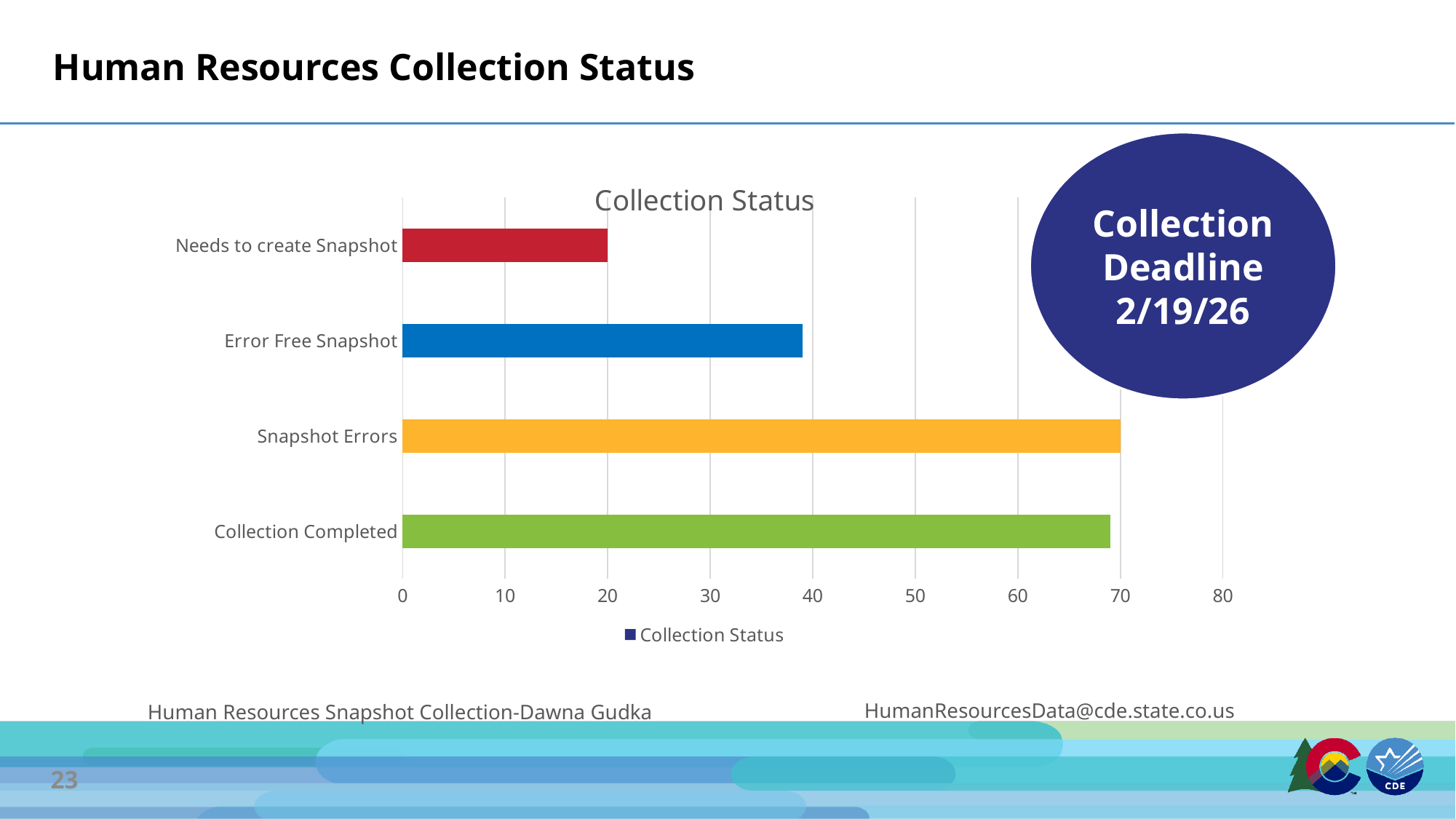
Which is larger, the value for Needs to create Snapshot or the value for Error Free Snapshot? Error Free Snapshot What kind of chart is shown on the slide? bar chart What is the name of the series shown in the legend? Collection Status Is the value for Needs to create Snapshot greater or less than 30? less Is the value for Collection Completed greater or less than 60? greater What is the title of the chart? Collection Status How many categories are shown in the chart? 4 Which is larger, the value for Error Free Snapshot or the value for Collection Completed? Collection Completed Is the value for Snapshot Errors greater or less than 60? greater How many series does the legend list? 1 Which category has the lowest value? Needs to create Snapshot